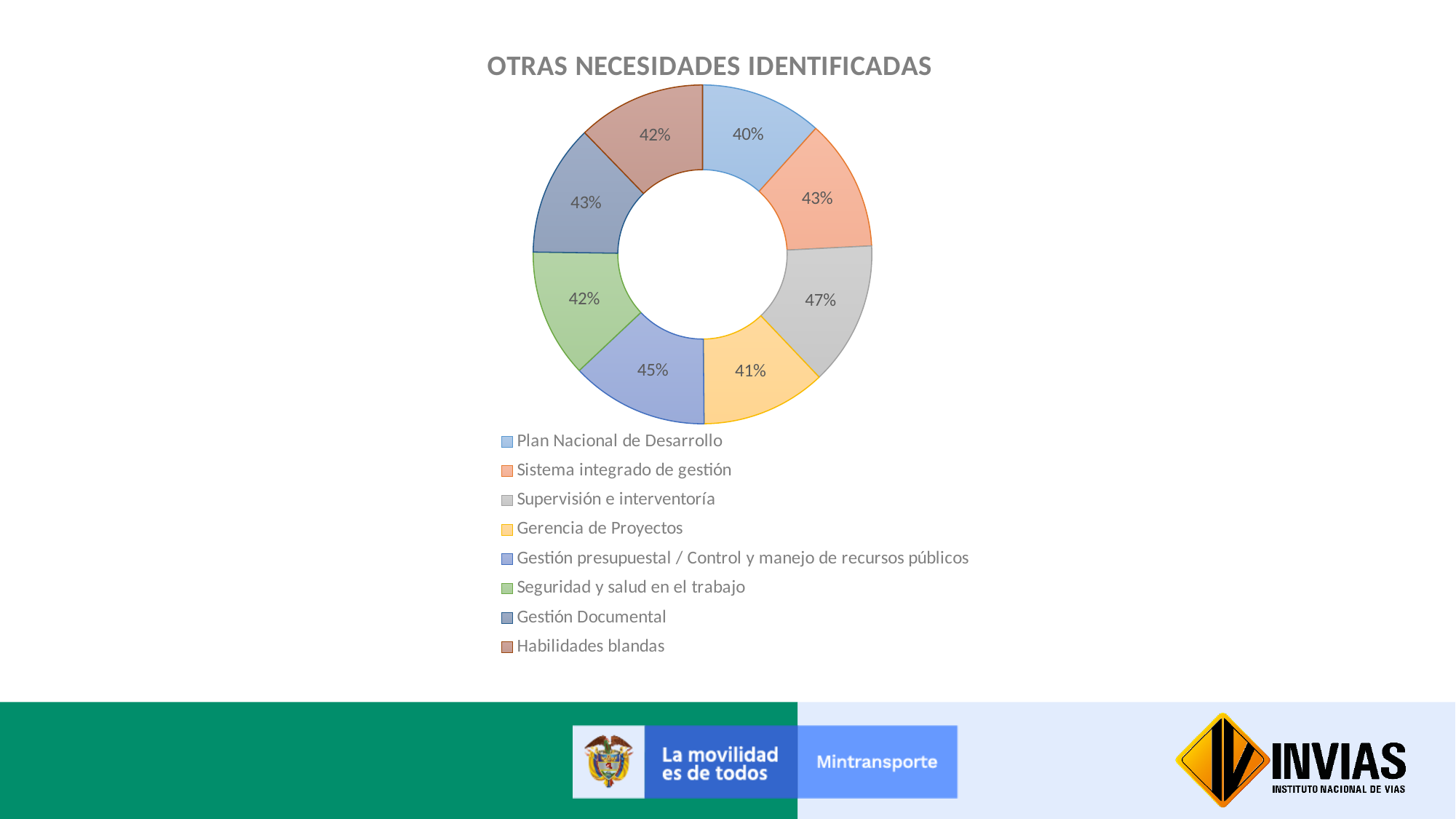
What value is shown for Gestión presupuestal / Control y manejo de recursos públicos? 45% What is the title of the chart? OTRAS NECESIDADES IDENTIFICADAS How many categories does the legend list? 8 What value is shown for Supervisión e interventoría? 47% What value is shown for Gerencia de Proyectos? 41% Which is larger, the value for Gestión presupuestal / Control y manejo de recursos públicos or the value for Gerencia de Proyectos? Gestión presupuestal / Control y manejo de recursos públicos Which category has the highest value? Supervisión e interventoría What type of chart is shown on the slide? Doughnut chart What value is shown for Habilidades blandas? 42% Which category has the lowest value? Plan Nacional de Desarrollo What is the difference between the values for Supervisión e interventoría and Plan Nacional de Desarrollo? 7% What value is shown for Plan Nacional de Desarrollo? 40%